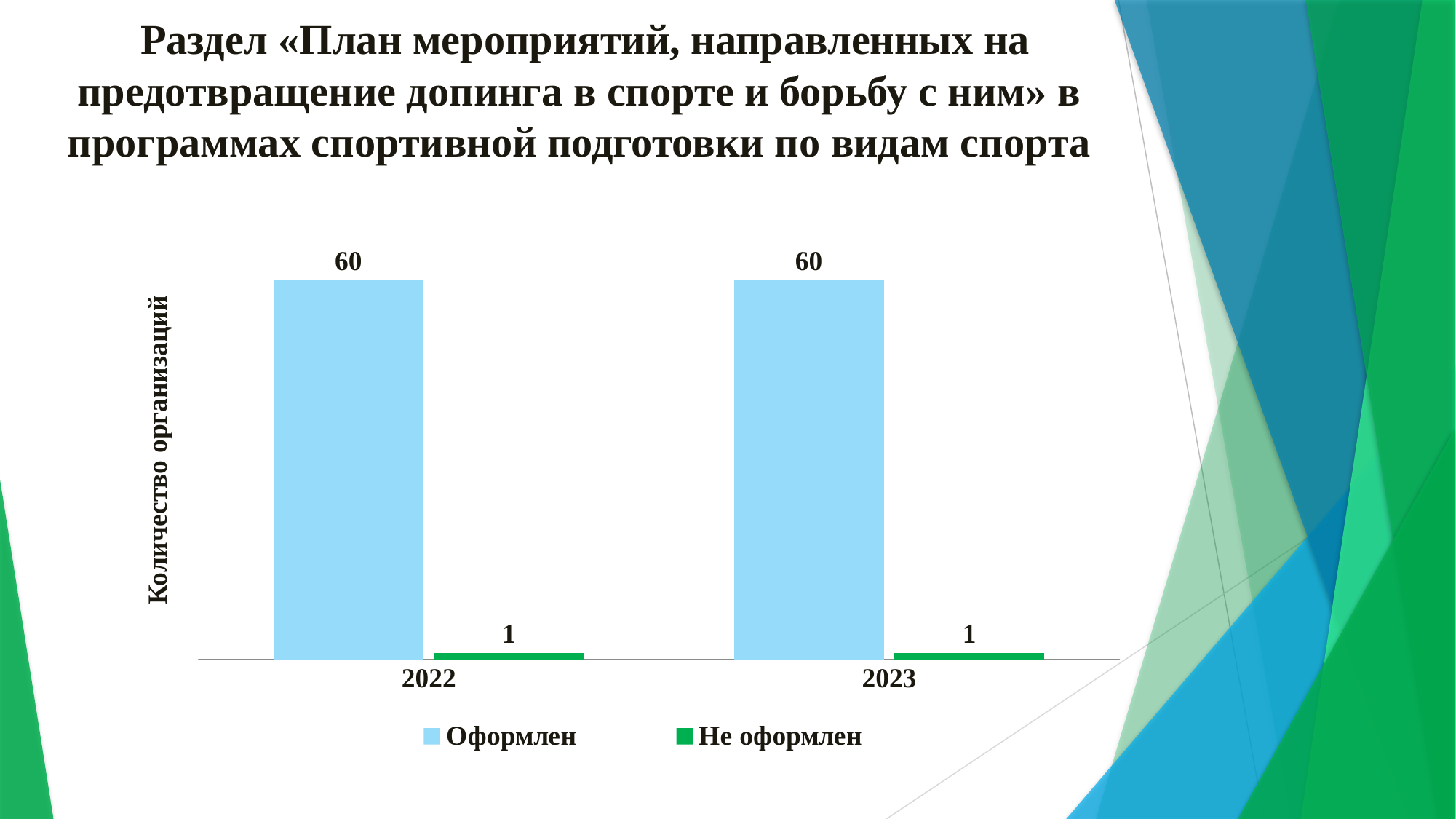
Which series has the larger value in 2023, «Оформлен» or «Не оформлен»? Оформлен What kind of chart is shown on the slide? Bar chart What is the label of the vertical axis? Количество организаций What is the value for «Не оформлен» in 2023? 1 How many series does the legend list? 2 Does the value for «Оформлен» rise, fall or stay the same from 2022 to 2023? Stays the same Which colour represents the «Не оформлен» series in the legend? Green What is the value for «Оформлен» in 2022? 60 What is the value for «Не оформлен» in 2022? 1 What is the difference between «Оформлен» and «Не оформлен» in 2022? 59 What is the value for «Оформлен» in 2023? 60 How many categories are shown on the x axis? 2